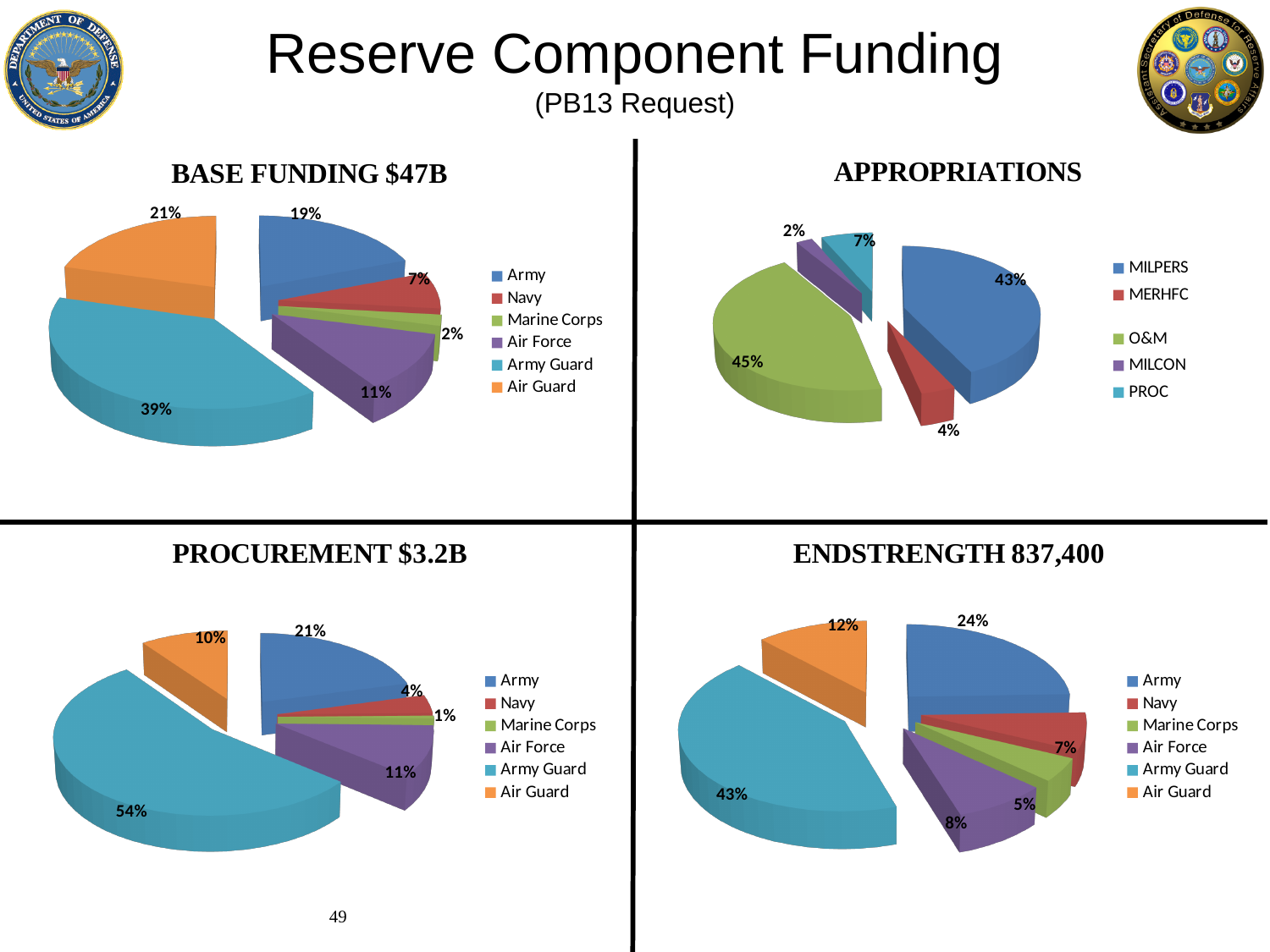
How many pie charts are shown on the slide? 4 In the ENDSTRENGTH 837,400 chart, what share does Air Force have? 8% In the BASE FUNDING $47B chart, which category has the smallest share? Marine Corps In the APPROPRIATIONS chart, which category has the largest share? O&M In the ENDSTRENGTH 837,400 chart, what is the difference between the Army Guard and Army shares? 19% In the APPROPRIATIONS chart, what share does O&M have? 45% In the PROCUREMENT $3.2B chart, what share does Army Guard have? 54% How many categories does the legend of the APPROPRIATIONS chart list? 5 In the BASE FUNDING $47B chart, what is the difference between the Air Guard and Army shares? 2% In the BASE FUNDING $47B chart, what share does Army Guard have? 39% What kind of chart is the ENDSTRENGTH 837,400 chart? Pie chart In the PROCUREMENT $3.2B chart, which is larger, the Air Force share or the Air Guard share? Air Force